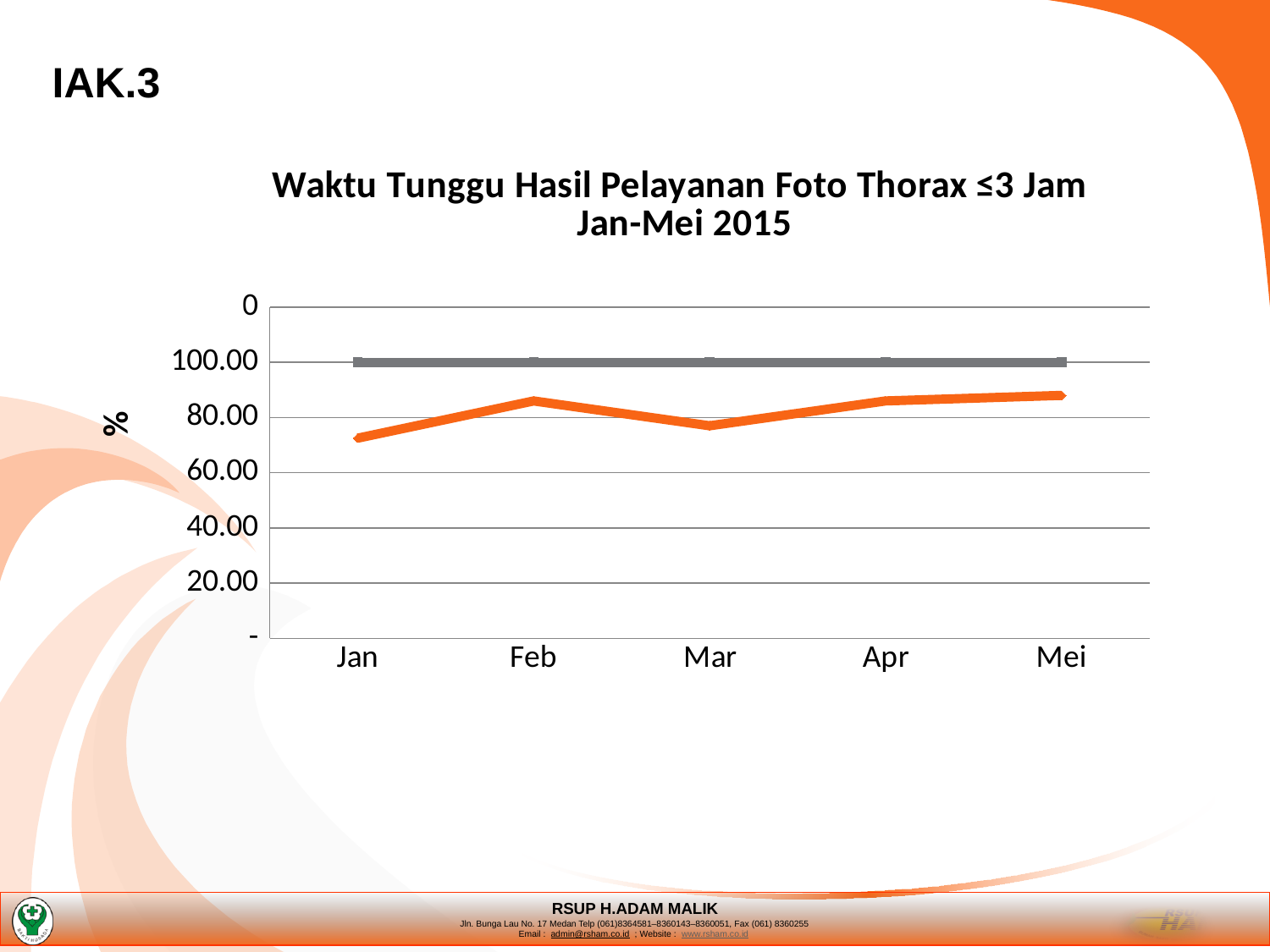
Does the orange line rise or fall from Feb to Mar? fall What is the title of the chart? Waktu Tunggu Hasil Pelayanan Foto Thorax ≤3 Jam Jan-Mei 2015 How many months are shown on the x axis of the chart? 5 Is the value of the orange line for Jan greater or less than 80.00? less What is the label on the vertical axis of the chart? % What kind of chart is shown on the slide? line chart Is the value of the orange line for Mei greater or less than 100.00? less At what value does the flat gray line sit across all months? 100.00 In which month is the orange line at its lowest value? Jan Is the value of the orange line for Feb greater or less than 80.00? greater Which month has the larger value on the orange line, Jan or Feb? Feb How many lines are plotted on the chart? 2